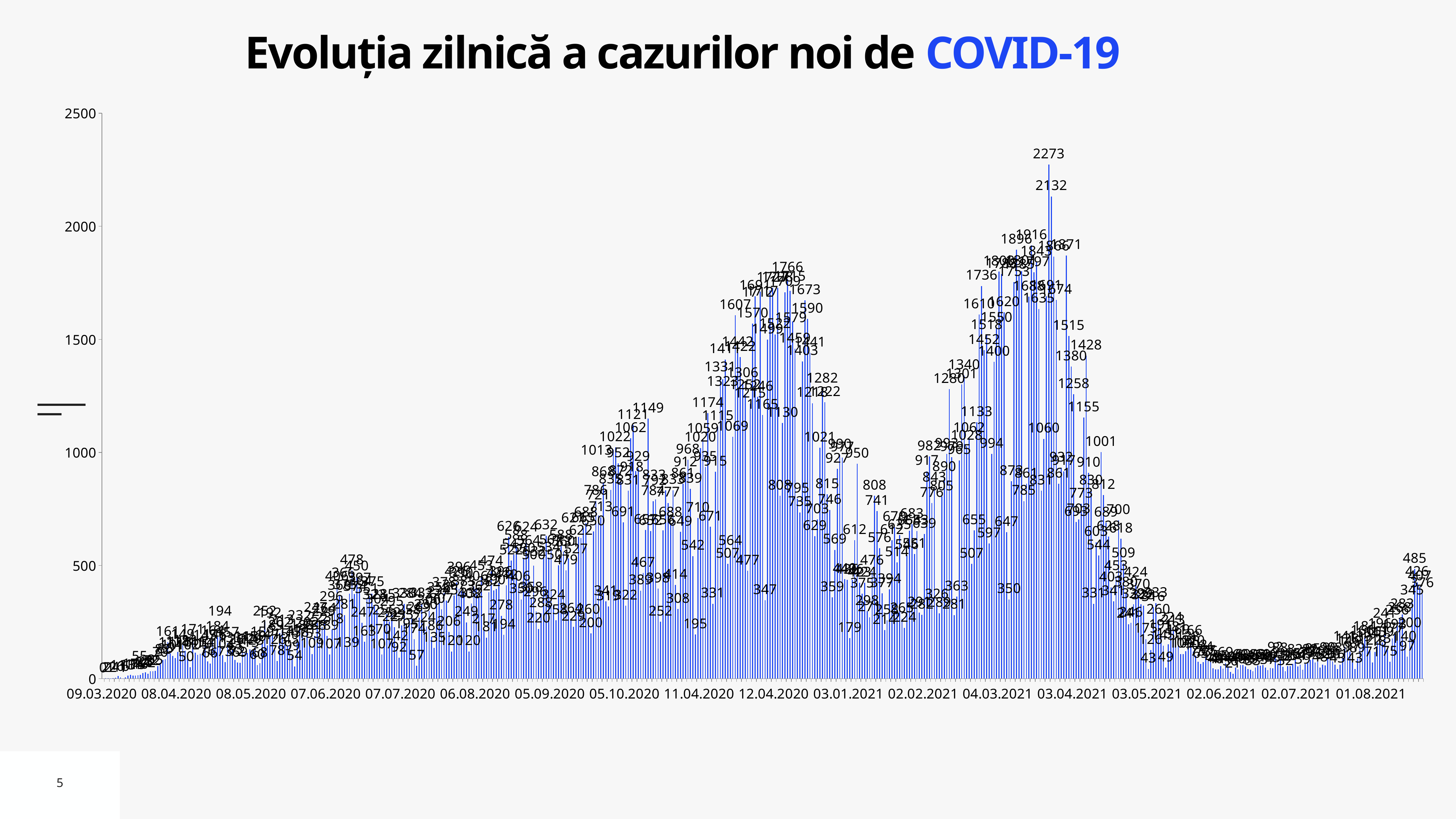
Is the peak of the wave around 03.04.2021 higher or lower than the peak of the wave around 12.04.2020? higher What is the title of the chart? Evoluția zilnică a cazurilor noi de COVID-19 Do the daily values rise or fall between 03.04.2021 and 03.05.2021? fall Do the daily values rise or fall between 09.03.2020 and 08.04.2020? rise What is the last date label on the horizontal axis? 01.08.2021 What is the second-highest value labelled on the chart, just below the 2273 peak? 2132 What is the first date label on the horizontal axis? 09.03.2020 What is the highest daily value labelled on the chart? 2273 What kind of chart is shown on the slide? bar chart Is the highest bar on the chart greater or less than 2000? greater What is the difference between the two highest labelled values, 2273 and 2132? 141 What is the highest value shown on the vertical axis? 2500